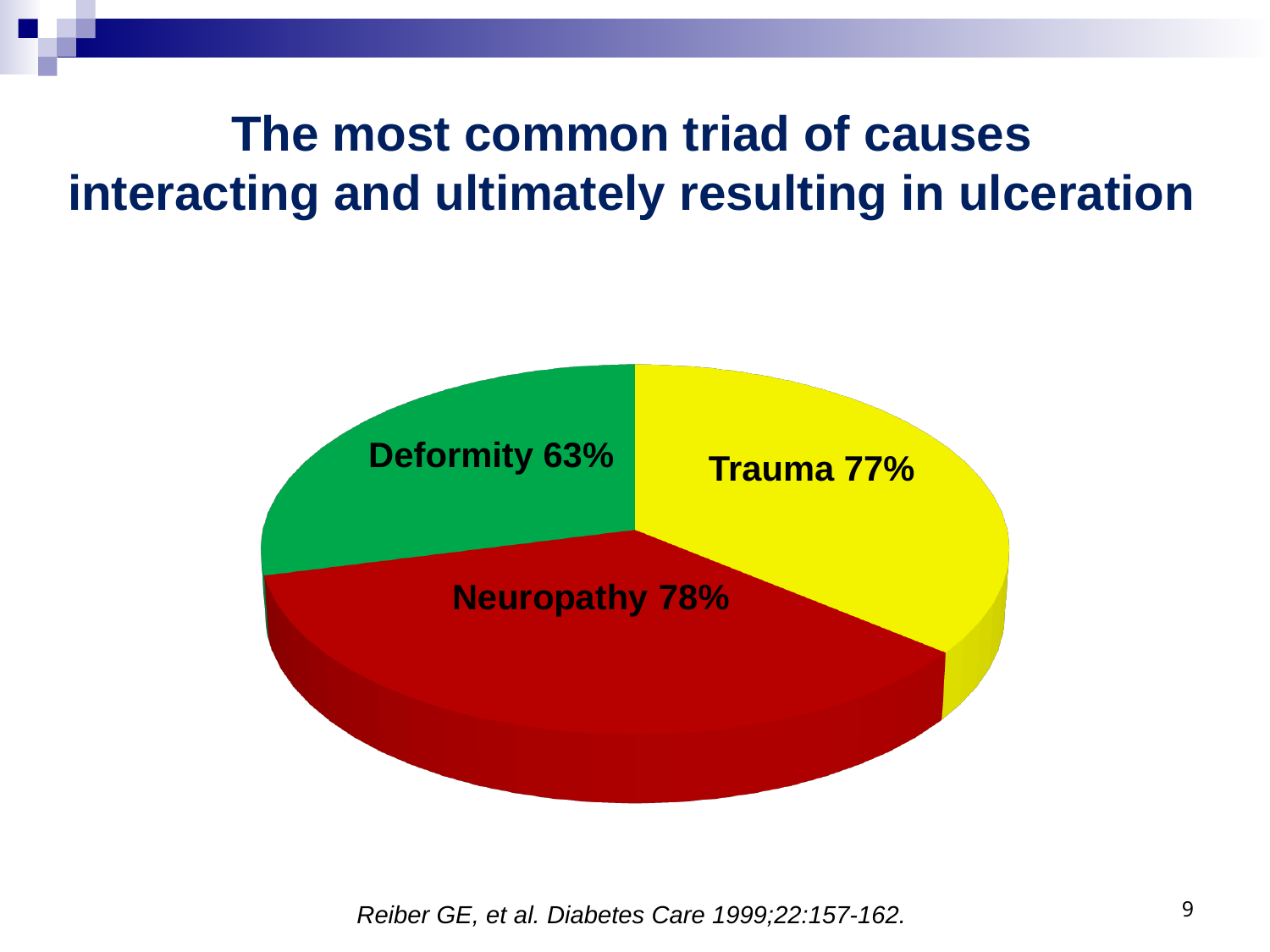
What percentage is shown for Neuropathy on the pie chart? 78% What is the difference in percentage points between Neuropathy and Deformity? 15 percentage points What colour is the Neuropathy slice of the pie chart? Red What is the difference in percentage points between Trauma and Deformity? 14 percentage points Which has a higher percentage, Trauma or Deformity? Trauma What percentage is shown for Trauma on the pie chart? 77% What kind of chart is shown on the slide? Pie chart What percentage is shown for Deformity on the pie chart? 63% Which cause has the lowest percentage on the pie chart? Deformity What is the title of the slide containing the pie chart? The most common triad of causes interacting and ultimately resulting in ulceration How many causes are shown as slices in the pie chart? 3 Which cause has the highest percentage on the pie chart? Neuropathy